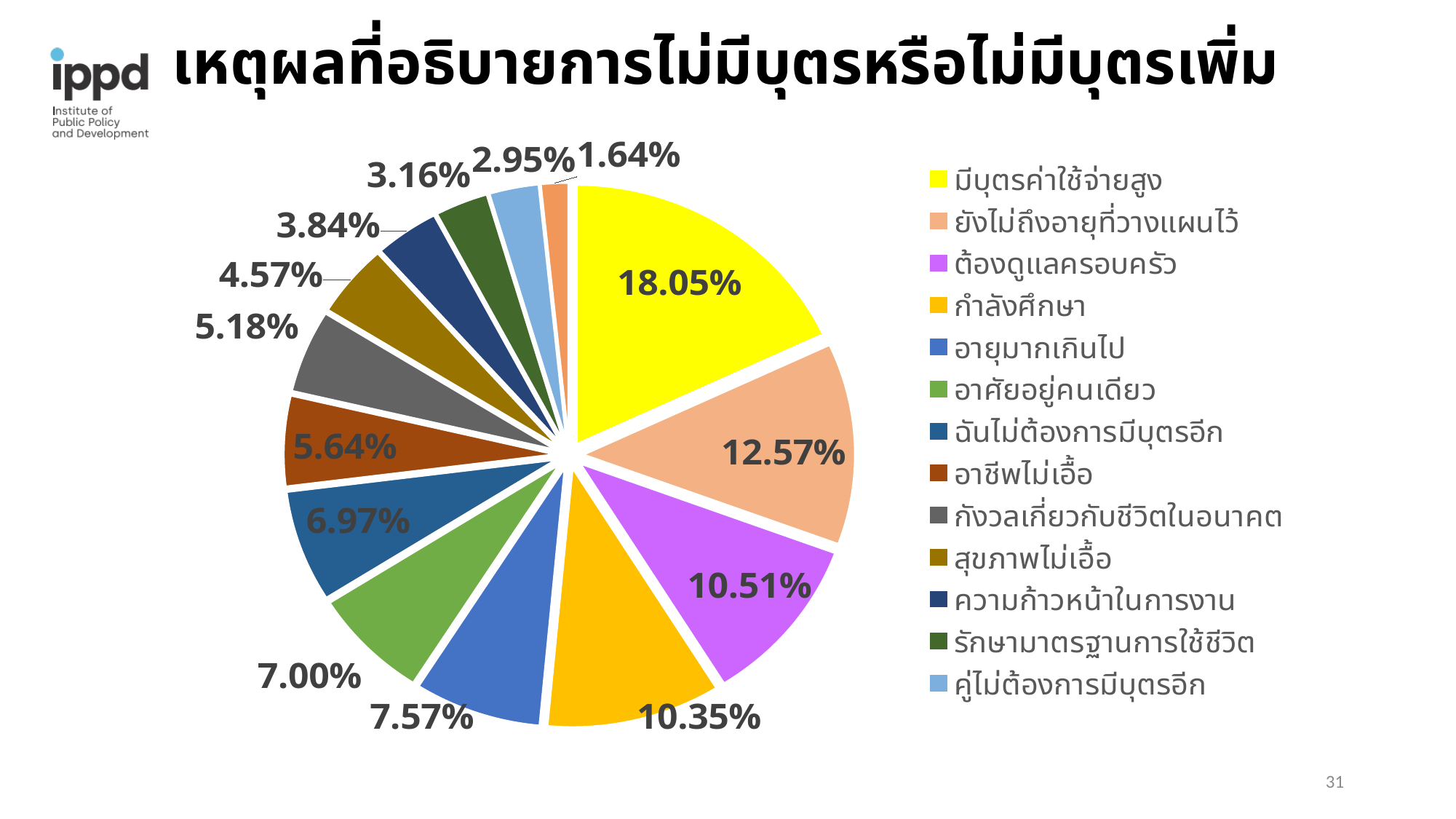
What is the title of the slide? เหตุผลที่อธิบายการไม่มีบุตรหรือไม่มีบุตรเพิ่ม Which has a larger share: อายุมากเกินไป or สุขภาพไม่เอื้อ? อายุมากเกินไป What is the difference in percentage points between มีบุตรค่าใช้จ่ายสูง and ยังไม่ถึงอายุที่วางแผนไว้? 5.48 What kind of chart is shown on the slide? pie chart What percentage is shown for มีบุตรค่าใช้จ่ายสูง? 18.05% What percentage is shown for ความก้าวหน้าในการงาน? 3.84% How many entries does the legend list? 13 What percentage is shown for กำลังศึกษา? 10.35% What percentage is shown for อาชีพไม่เอื้อ? 5.64% What percentage is shown for ยังไม่ถึงอายุที่วางแผนไว้? 12.57% What is the smallest percentage shown on the pie chart? 1.64% Which category has the largest share of the pie? มีบุตรค่าใช้จ่ายสูง